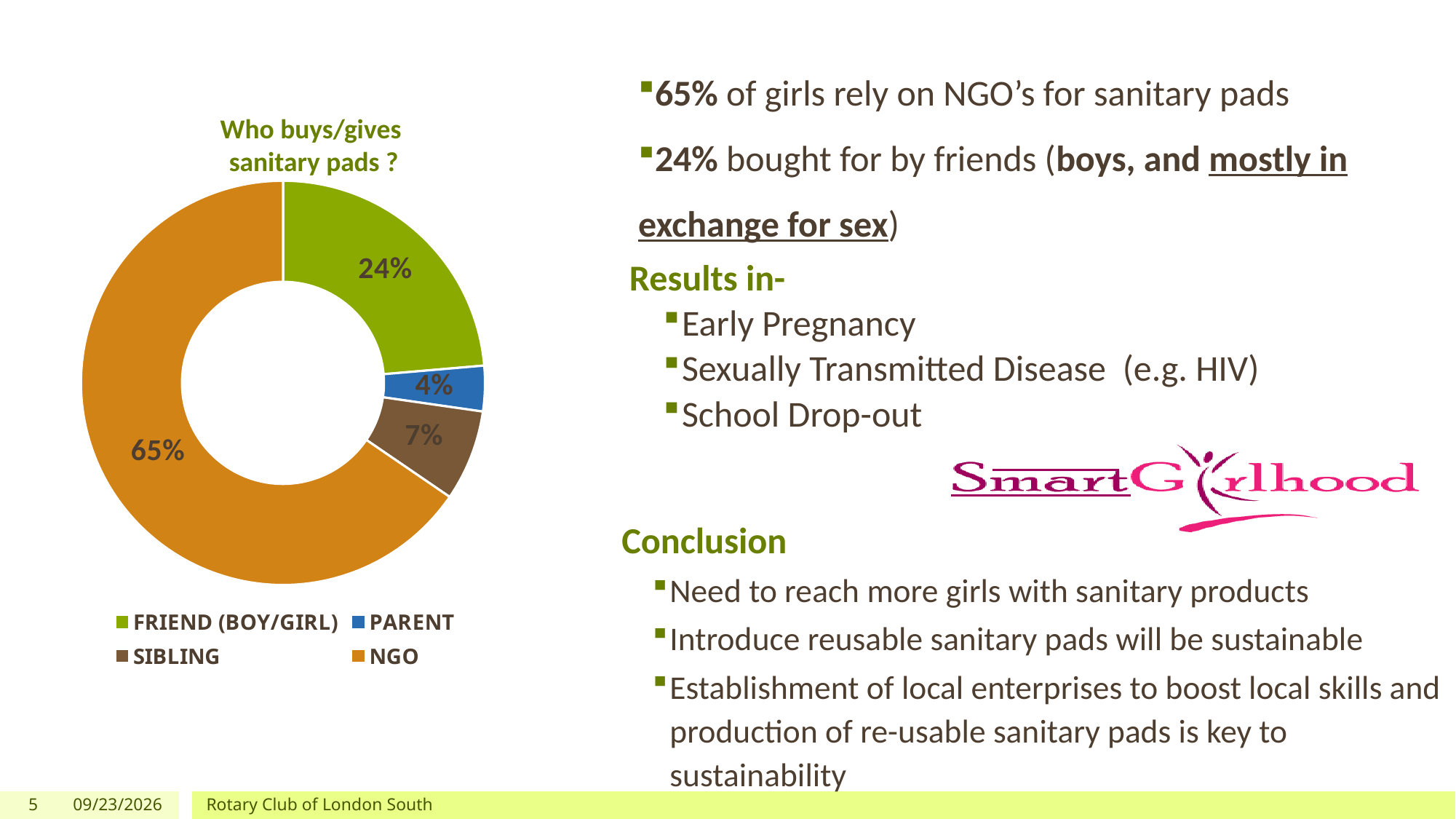
What percentage is shown for FRIEND (BOY/GIRL)? 24% What colour represents NGO in the chart? Orange What percentage is shown for SIBLING? 7% What share of the chart does NGO account for? 65% How many categories does the chart show? 4 Which is larger, the share for SIBLING or the share for PARENT? SIBLING What is the difference in percentage points between NGO and FRIEND (BOY/GIRL)? 41 Which category has the smallest share of the chart? PARENT What percentage is shown for PARENT? 4% What kind of chart is shown on the slide? Doughnut (pie) chart Which category has the largest share of the chart? NGO What is the title of the chart? Who buys/gives sanitary pads ?